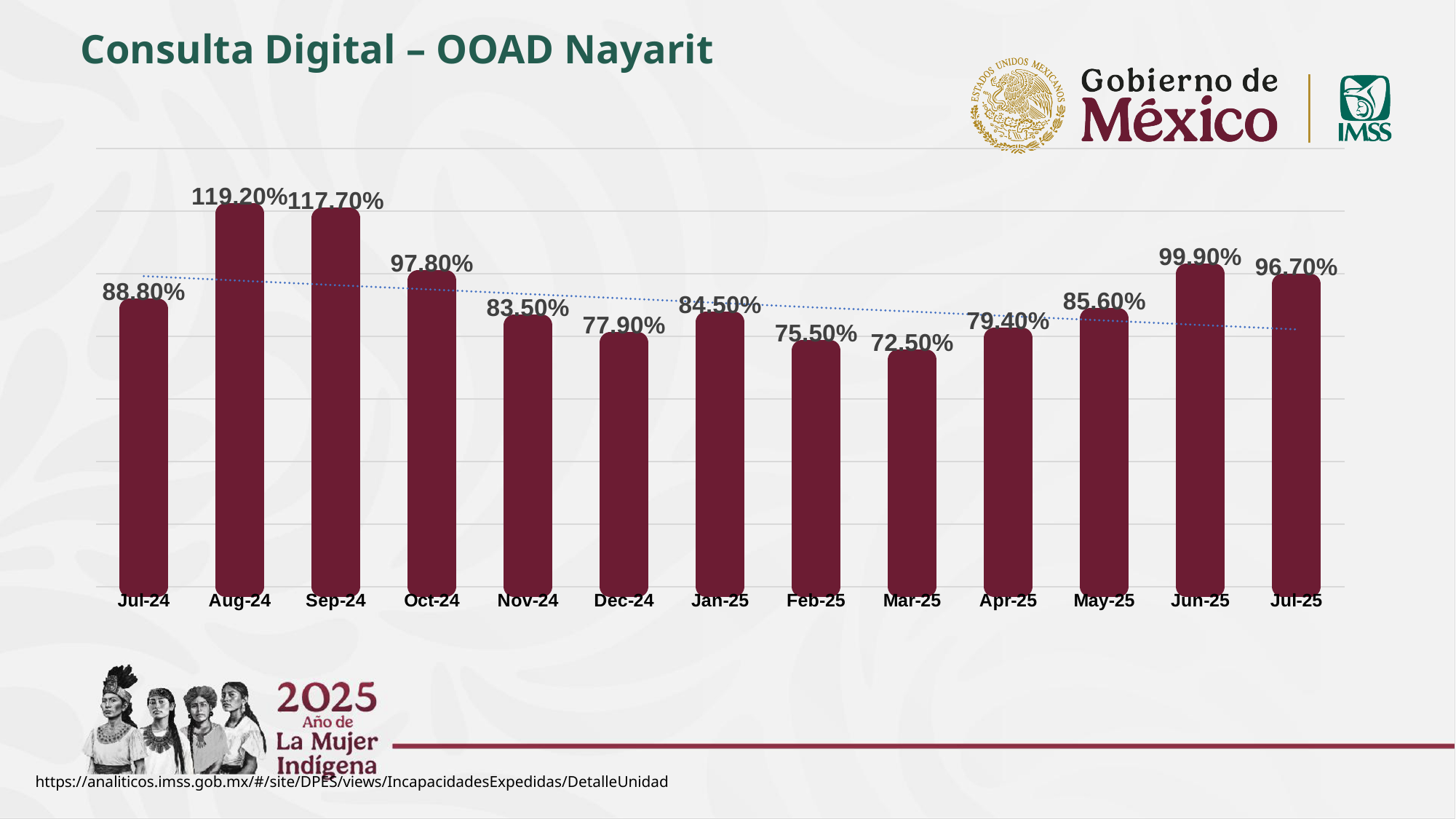
What is the title of the slide? Consulta Digital – OOAD Nayarit Which month has the highest value? Aug-24 Which is larger, the value for Oct-24 or the value for Jun-25? Jun-25 Which month has the lowest value? Mar-25 What is the value for Jul-25? 96.70% What is the value for Mar-25? 72.50% What is the difference between the values for Aug-24 and Sep-24? 1.50% What is the difference between the values for Jun-25 and Mar-25? 27.40% Which is larger, the value for Nov-24 or the value for Dec-24? Nov-24 How many months are shown on the x axis? 13 What is the value for Aug-24? 119.20% What kind of chart is shown on the slide? Bar chart